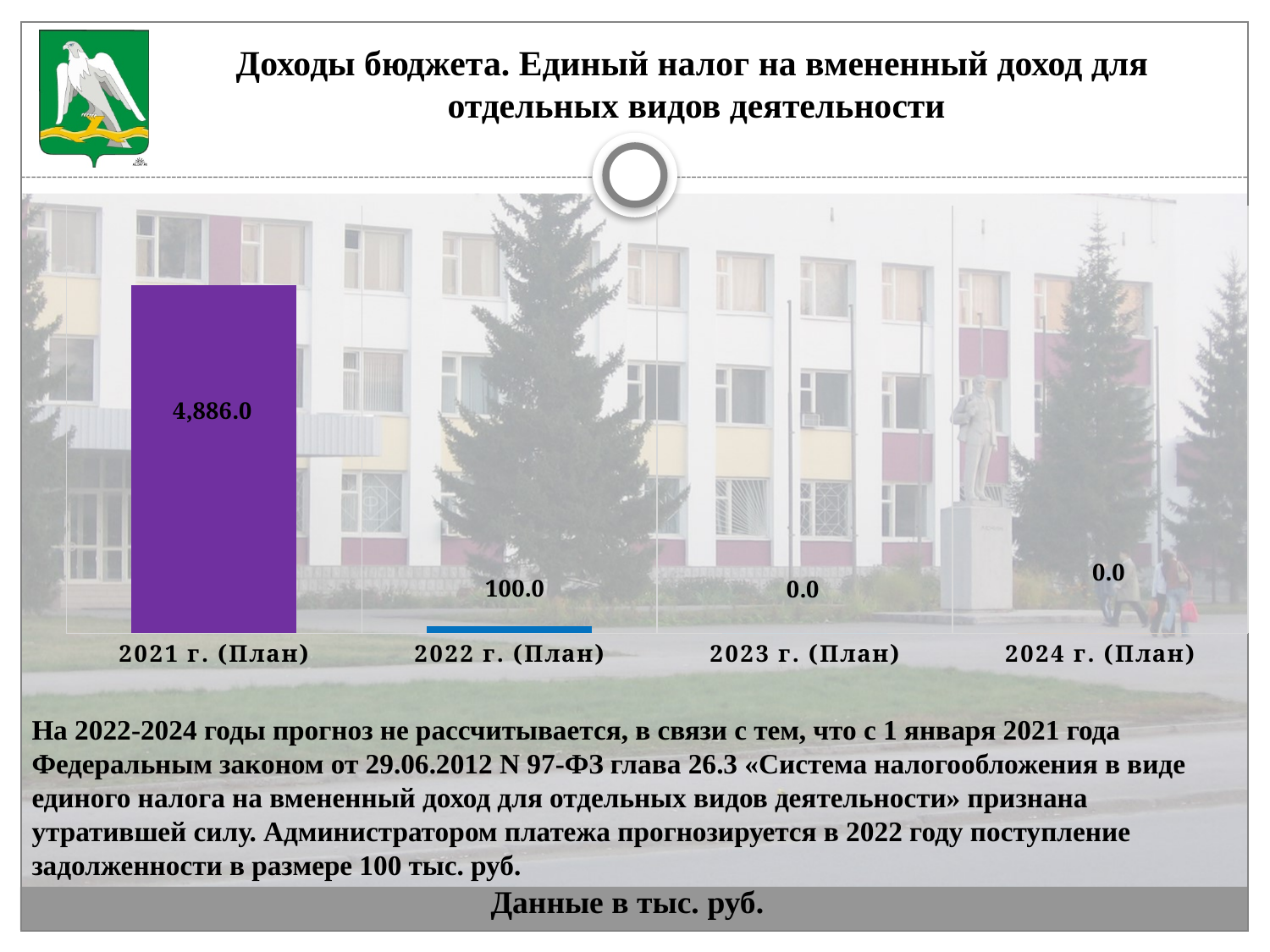
What is the difference between the values for 2021 г. (План) and 2022 г. (План)? 4,786.0 How many categories are shown on the x axis? 4 Do the values rise or fall from 2021 г. (План) to 2023 г. (План)? fall Which is larger, the value for 2021 г. (План) or 2022 г. (План)? 2021 г. (План) What is the value for 2023 г. (План)? 0.0 What kind of chart is shown on the slide? bar chart What is the value for 2024 г. (План)? 0.0 What is the value for 2021 г. (План)? 4,886.0 What is the total of the values for 2022 г. (План), 2023 г. (План) and 2024 г. (План)? 100.0 What is the value for 2022 г. (План)? 100.0 In what units are the chart data given, according to the slide? тыс. руб. Which category has the highest value? 2021 г. (План)